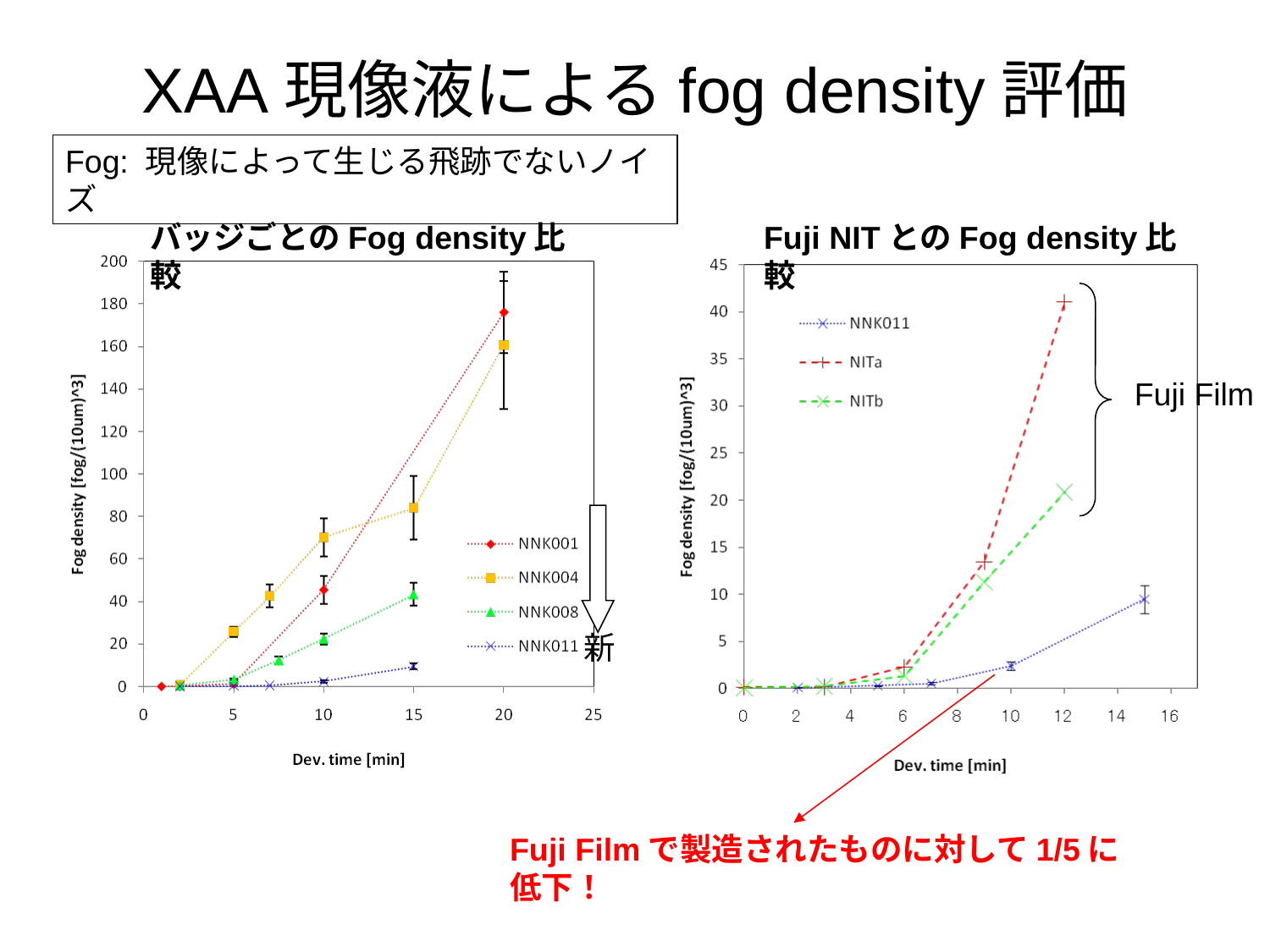
In the left chart 'バッジごとの Fog density 比較', is the value for NNK001 at 20 min greater or less than 140? greater In the right chart 'Fuji NIT との Fog density 比較', which series has the highest fog density at 12 min? NITa In the left chart 'バッジごとの Fog density 比較', which series has the lowest fog density at 15 min? NNK011 In the right chart 'Fuji NIT との Fog density 比較', is the value for NITa at 12 min greater or less than 35? greater How many series does the legend of the right chart 'Fuji NIT との Fog density 比較' list? 3 How many series does the legend of the left chart 'バッジごとの Fog density 比較' list? 4 In the right chart 'Fuji NIT との Fog density 比較', is the value for NNK011 at 15 min greater or less than 15? less What is the x-axis label of the right chart 'Fuji NIT との Fog density 比較'? Dev. time [min] In the left chart 'バッジごとの Fog density 比較', which is larger at 15 min: NNK004 or NNK008? NNK004 What kind of chart is the left chart titled 'バッジごとの Fog density 比較'? line chart In the right chart 'Fuji NIT との Fog density 比較', does the fog density for NITb rise or fall as development time increases? rise